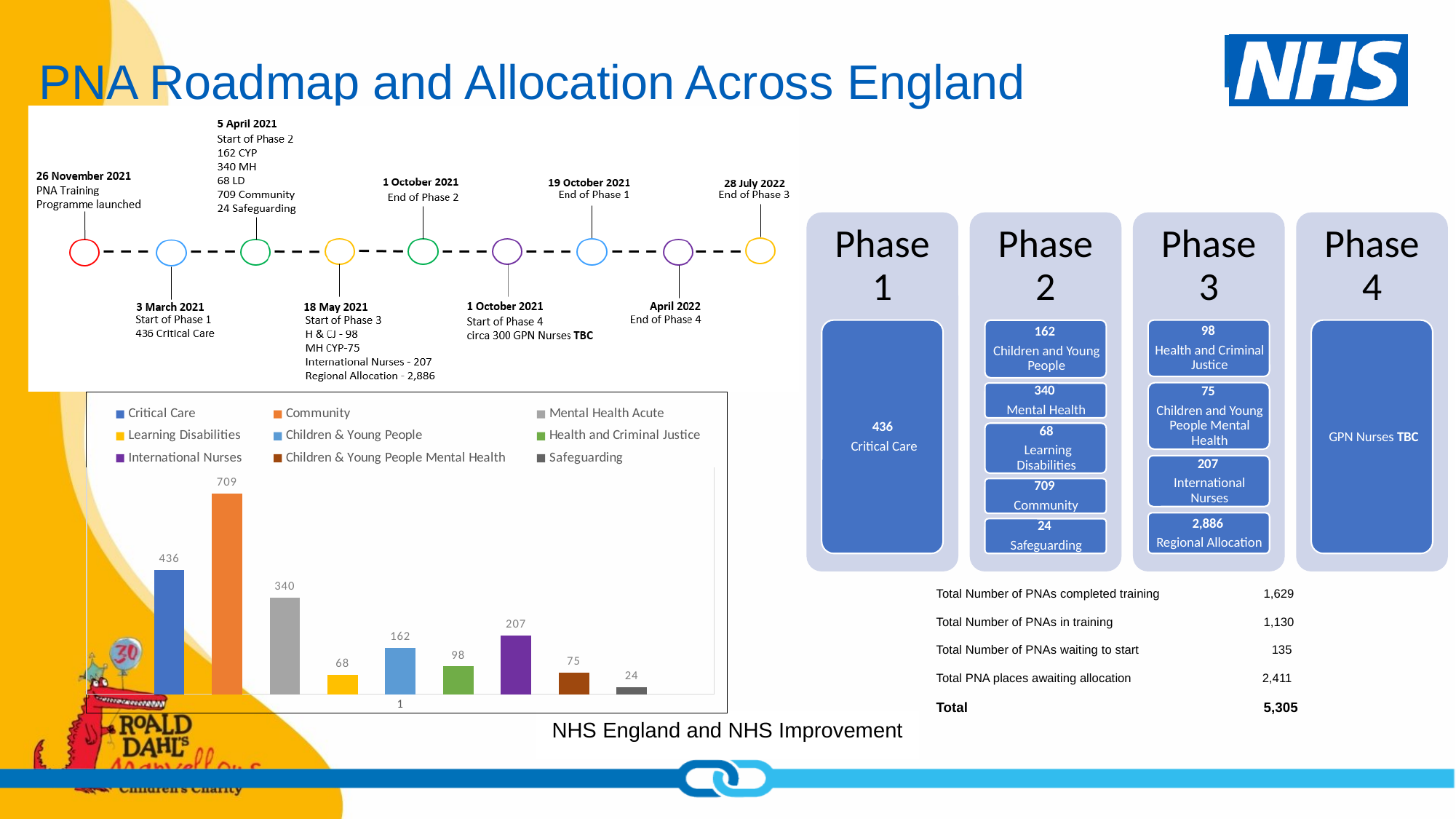
What is the difference between the Mental Health Acute and Learning Disabilities values in the bar chart? 272 Which series has the highest value in the bar chart? Community In the bar chart, which is larger: Children & Young People or Health and Criminal Justice? Children & Young People What is the value for Critical Care in the bar chart? 436 What colour is the Community bar in the bar chart? Orange What kind of chart is shown on the slide? Bar chart What is the value for International Nurses in the bar chart? 207 Which series has the lowest value in the bar chart? Safeguarding What is the value for Safeguarding in the bar chart? 24 What is the value for Community in the bar chart? 709 What is the difference between the Community and Critical Care values in the bar chart? 273 How many series does the legend of the bar chart list? 9